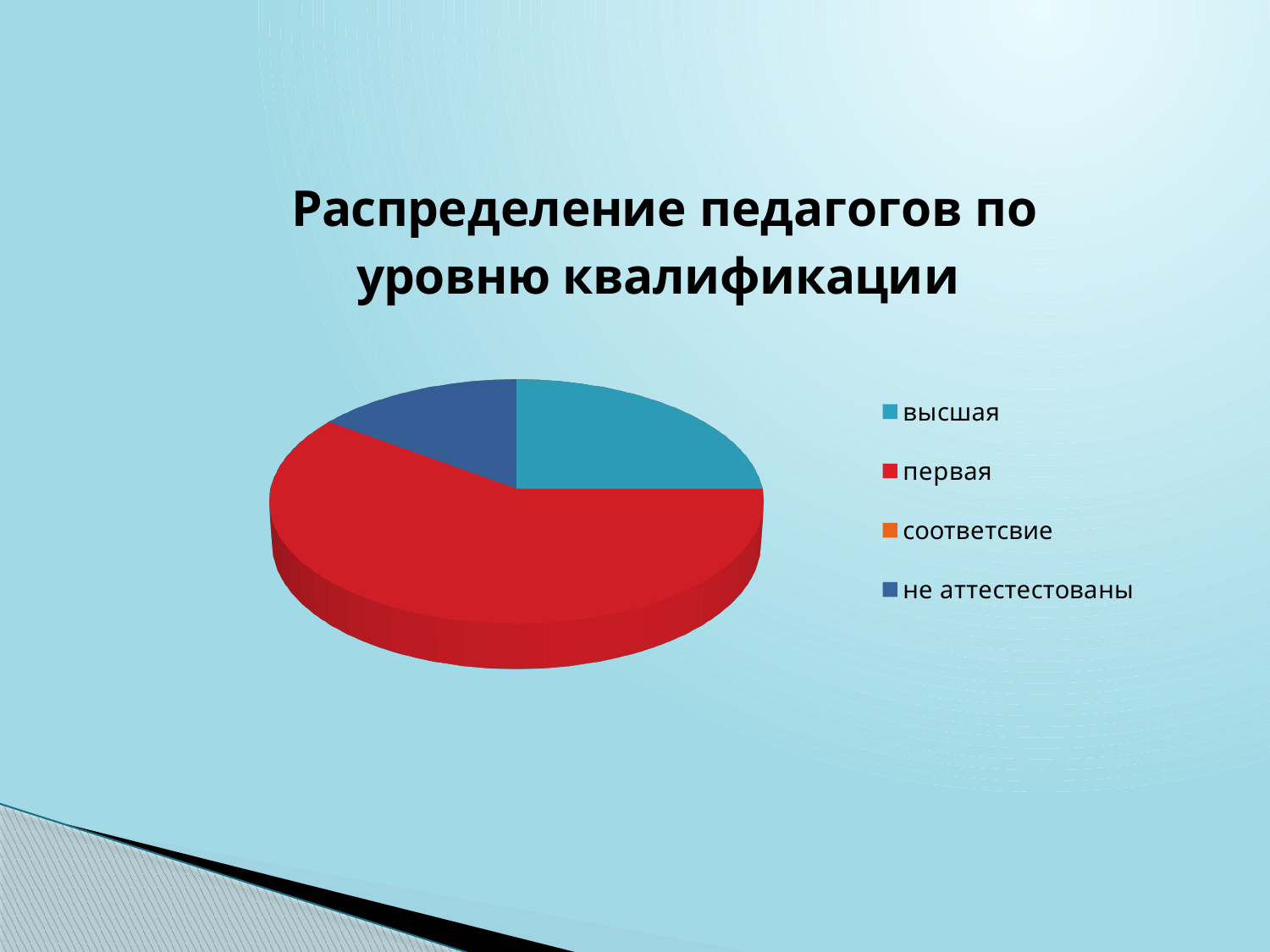
Which slice is larger, высшая or не аттестестованы? высшая Which slice is larger, первая or не аттестестованы? первая What is the title of the chart? Распределение педагогов по уровню квалификации Which category has the largest slice of the pie? первая What kind of chart is shown on the slide? pie chart How many entries does the chart's legend list? 4 Which slice is larger, первая or высшая? первая Which legend entry has no visible slice in the pie? соответсвие